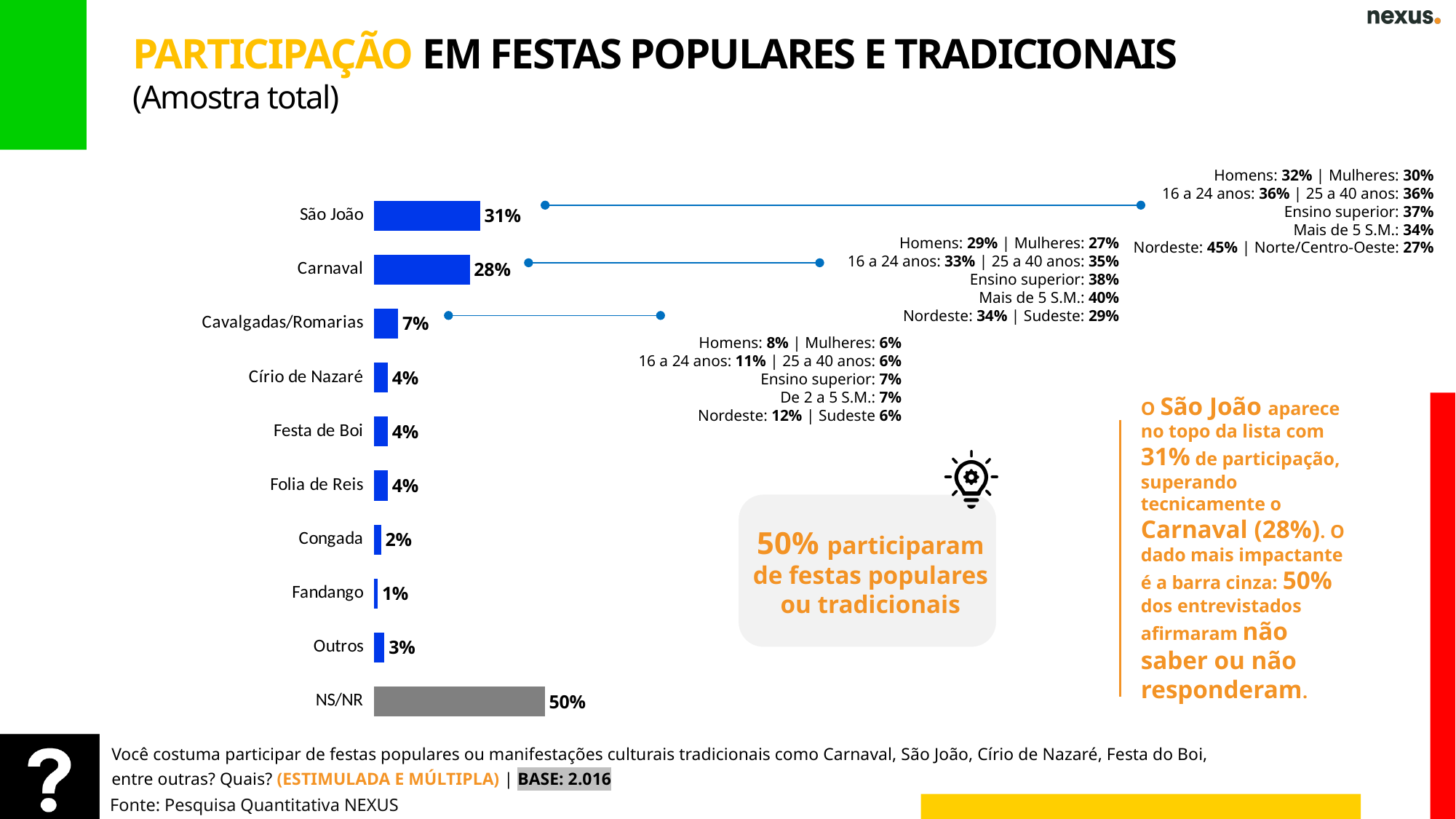
Which bar in the chart is coloured grey rather than blue? NS/NR Which category has the highest value in the chart? NS/NR What is the difference between the values for NS/NR and São João? 19% Which category has the lowest value in the chart? Fandango How many categories are shown in the chart? 10 What is the value for São João? 31% What is the value for NS/NR? 50% What is the value for Cavalgadas/Romarias? 7% What is the difference between the values for São João and Carnaval? 3% What kind of chart is shown on the slide? Bar chart Which is larger, the value for Congada or the value for Outros? Outros What is the value for Carnaval? 28%